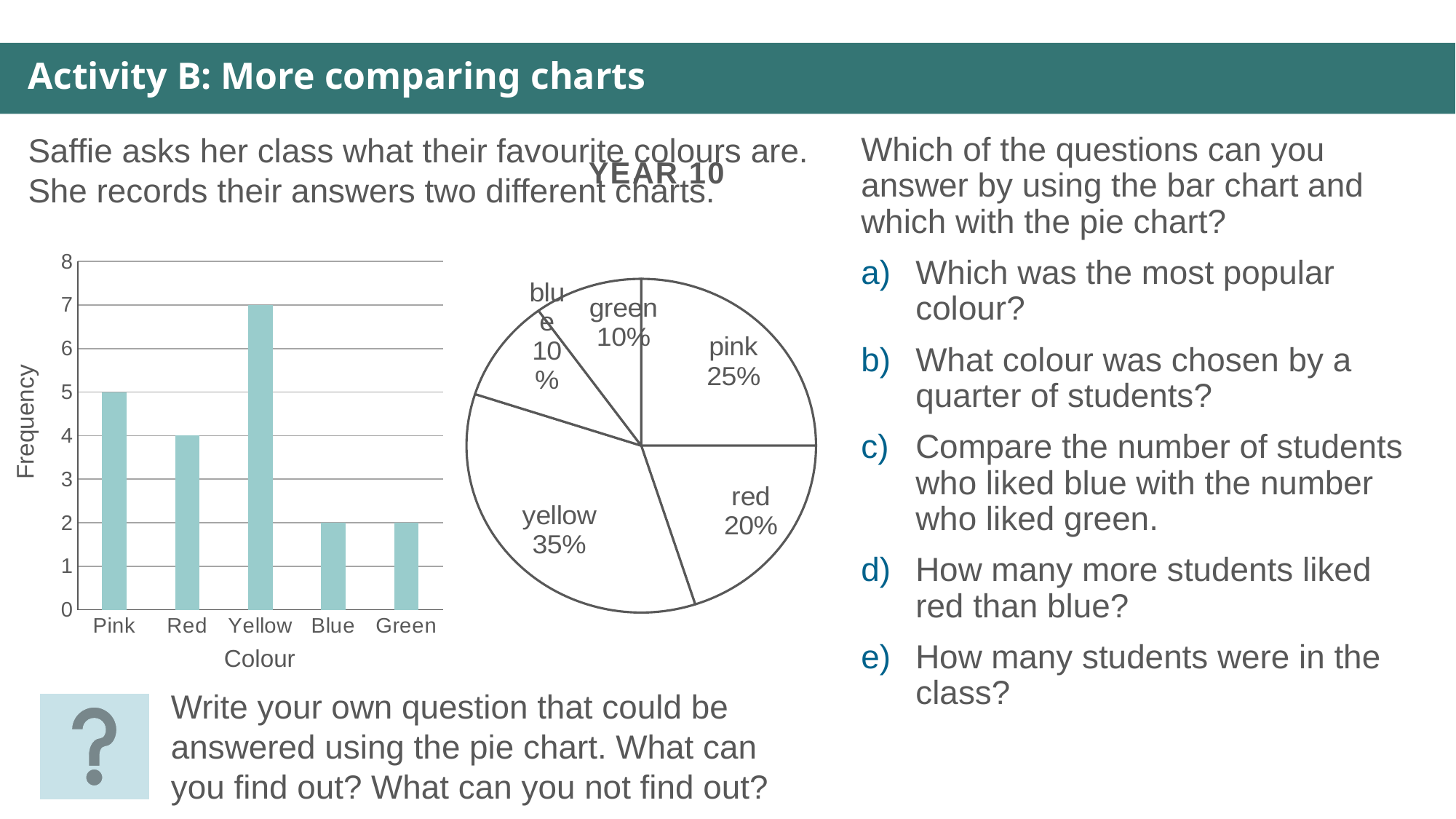
In the bar chart on the left, how many colour categories are shown on the x axis? 5 What kind of chart is the chart on the left of the slide? Bar chart In the pie chart, what is the difference between the percentages for pink and green? 15% In the bar chart on the left, which colour has the highest frequency? Yellow In the bar chart on the left, what is the label of the y axis? Frequency In the bar chart on the left, which is larger, the frequency for Red or the frequency for Blue? Red In the pie chart, what percentage is shown for red? 20% In the bar chart on the left, what is the frequency for Yellow? 7 In the bar chart on the left, what is the frequency for Pink? 5 In the pie chart, which colour has the largest slice? yellow In the bar chart on the left, what is the difference between the frequencies for Pink and Red? 1 In the pie chart, what percentage is shown for yellow? 35%